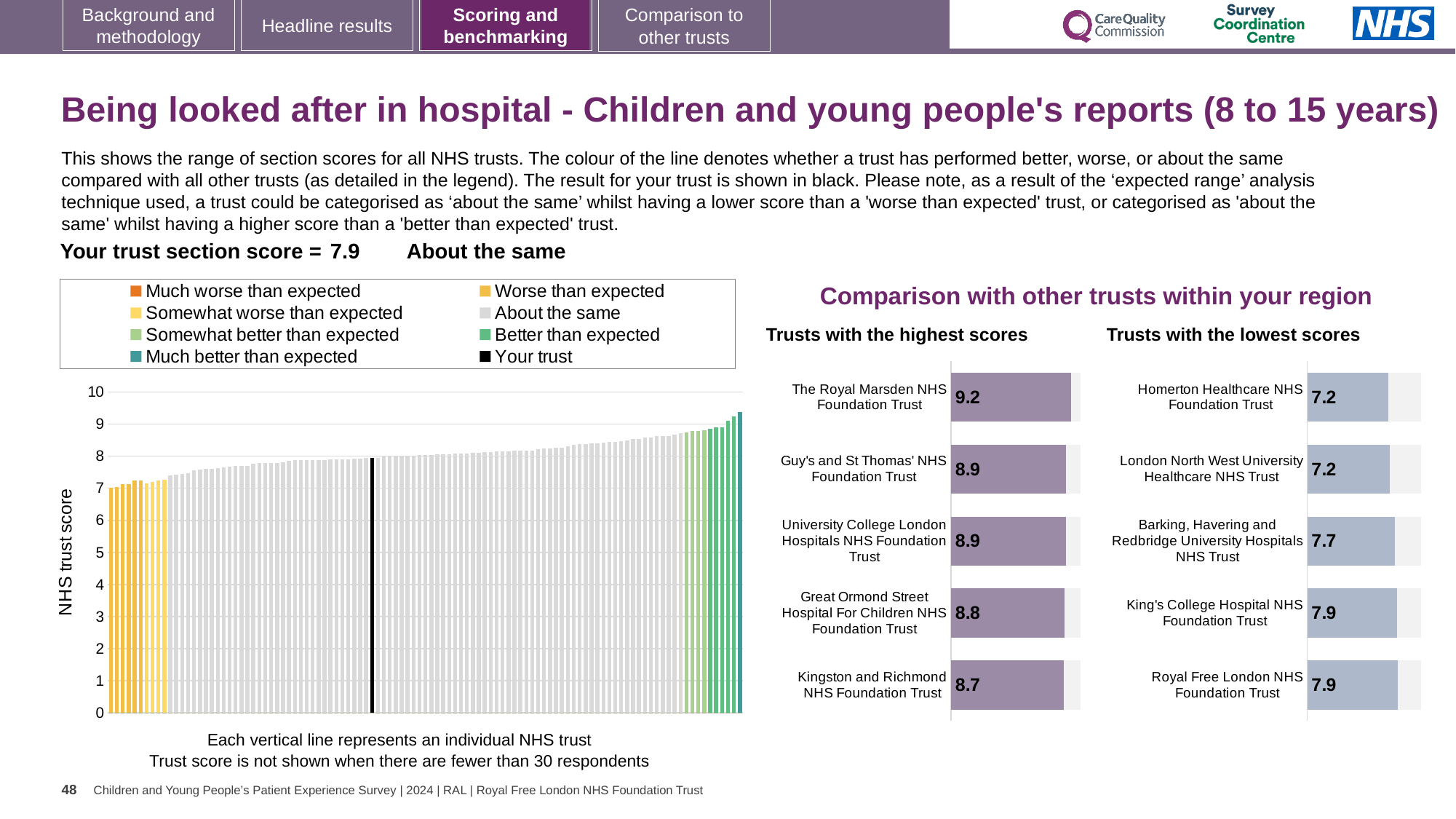
In the 'Trusts with the highest scores' chart, what is the difference between the scores of The Royal Marsden NHS Foundation Trust and Kingston and Richmond NHS Foundation Trust? 0.5 In the large chart on the left, what is the label on the vertical axis? NHS trust score How many entries does the legend above the large chart on the left list? 8 In the 'Trusts with the highest scores' chart, which trust has the lowest score? Kingston and Richmond NHS Foundation Trust How many trusts are shown in the 'Trusts with the lowest scores' chart? 5 In the 'Trusts with the lowest scores' chart, what is the score for Barking, Havering and Redbridge University Hospitals NHS Trust? 7.7 In the 'Trusts with the lowest scores' chart, which has the larger score: Barking, Havering and Redbridge University Hospitals NHS Trust or King's College Hospital NHS Foundation Trust? King's College Hospital NHS Foundation Trust In the large chart on the left, do the bar heights rise or fall from left to right? rise In the large chart on the left, is the value of the tallest bar greater or less than 9? greater What kind of chart is the large chart on the left of the slide showing all NHS trusts? bar chart In the large chart on the left, is the value of the shortest bar greater or less than 6? greater In the 'Trusts with the highest scores' chart, what is the score for The Royal Marsden NHS Foundation Trust? 9.2